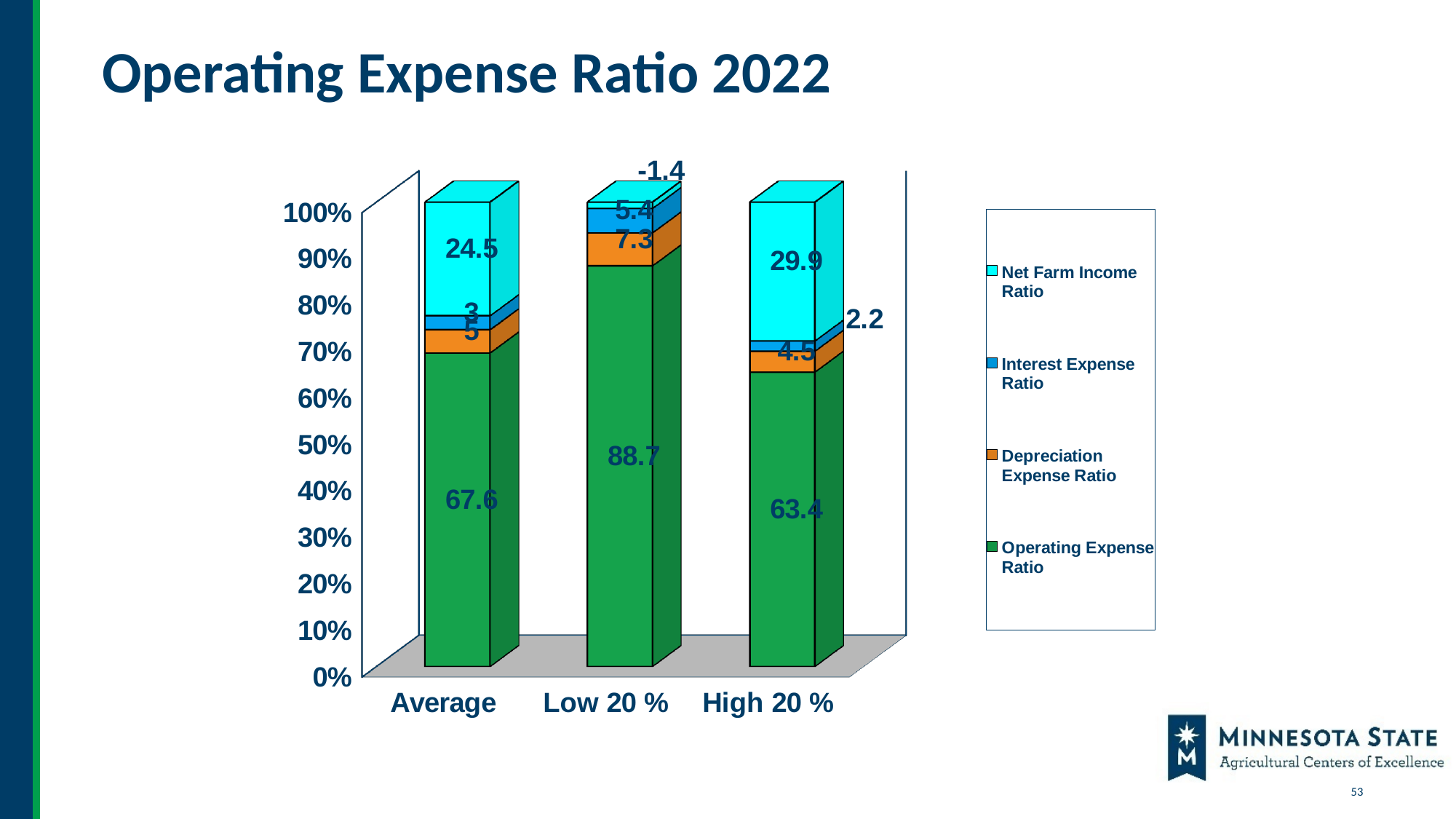
How many series does the legend list? 4 What is the difference in Operating Expense Ratio between the Low 20 % and High 20 % groups? 25.3 What is the Net Farm Income Ratio for the High 20 % group? 29.9 What is the Depreciation Expense Ratio for the Low 20 % group? 7.3 What is the Operating Expense Ratio for the Low 20 % group? 88.7 What is the Operating Expense Ratio for the Average group? 67.6 Which group has a larger Net Farm Income Ratio, Average or High 20 %? High 20 % What kind of chart is shown on the slide? Stacked bar chart Which group has the highest Operating Expense Ratio? Low 20 % What is the Net Farm Income Ratio for the Low 20 % group? -1.4 What is the Interest Expense Ratio for the High 20 % group? 2.2 Which group has the lowest Net Farm Income Ratio? Low 20 %